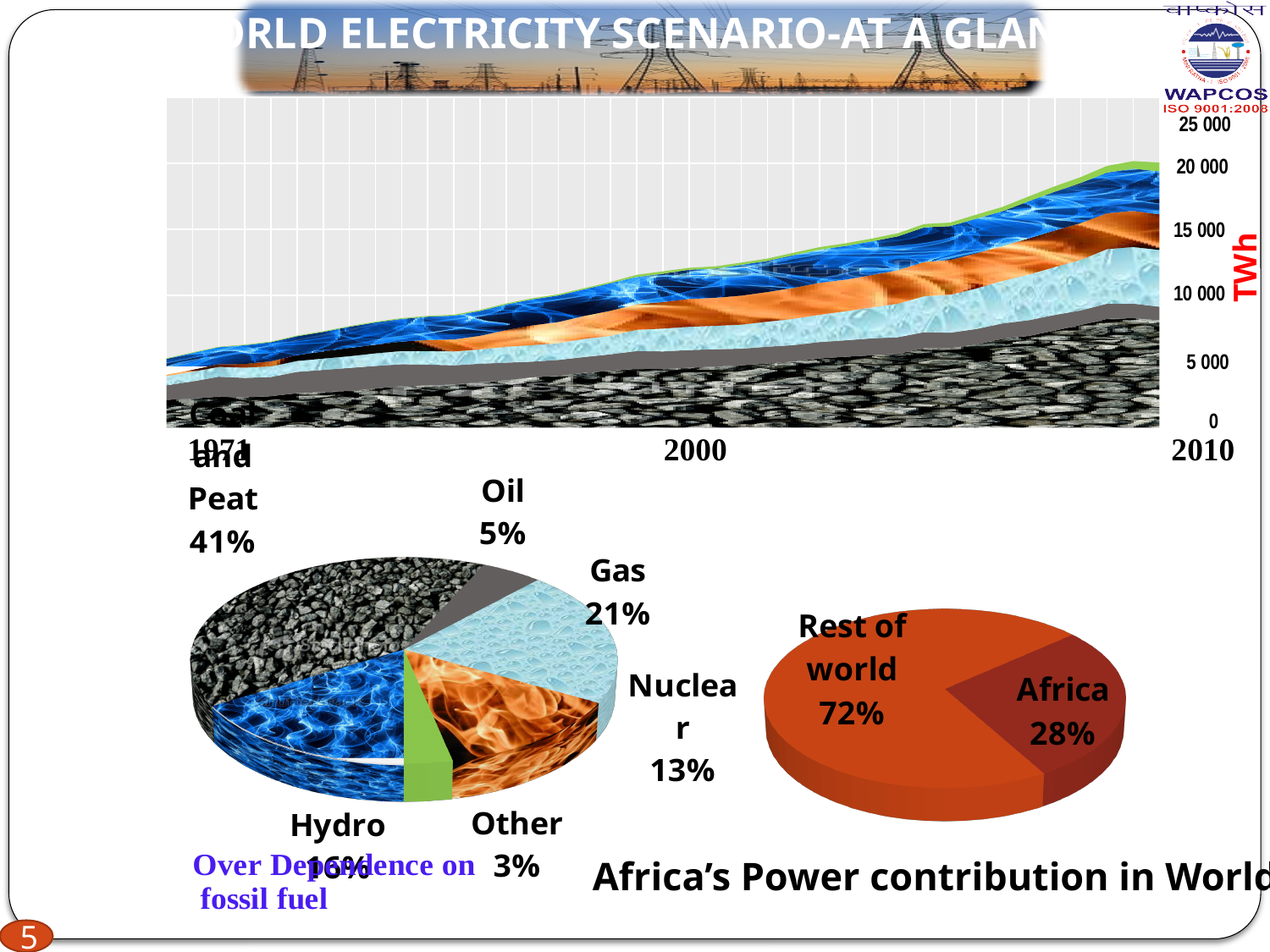
In the fuel-mix pie chart at the bottom left, which is larger, Gas or Nuclear? Gas In the stacked area chart at the top, is the total electricity generation in 2010 greater or less than 15 000 TWh? greater In the fuel-mix pie chart at the bottom left, what share is Gas? 21% In the 'Africa's Power contribution in World' pie chart, what share is Rest of world? 72% In the fuel-mix pie chart at the bottom left, which category has the smallest share? Other In the fuel-mix pie chart at the bottom left, what share is Nuclear? 13% In the fuel-mix pie chart at the bottom left, what is the difference between the Gas share and the Oil share? 16% In the fuel-mix pie chart at the bottom left, which fuel has the largest share? Coal and Peat In the 'Africa's Power contribution in World' pie chart, how many slices are there? 2